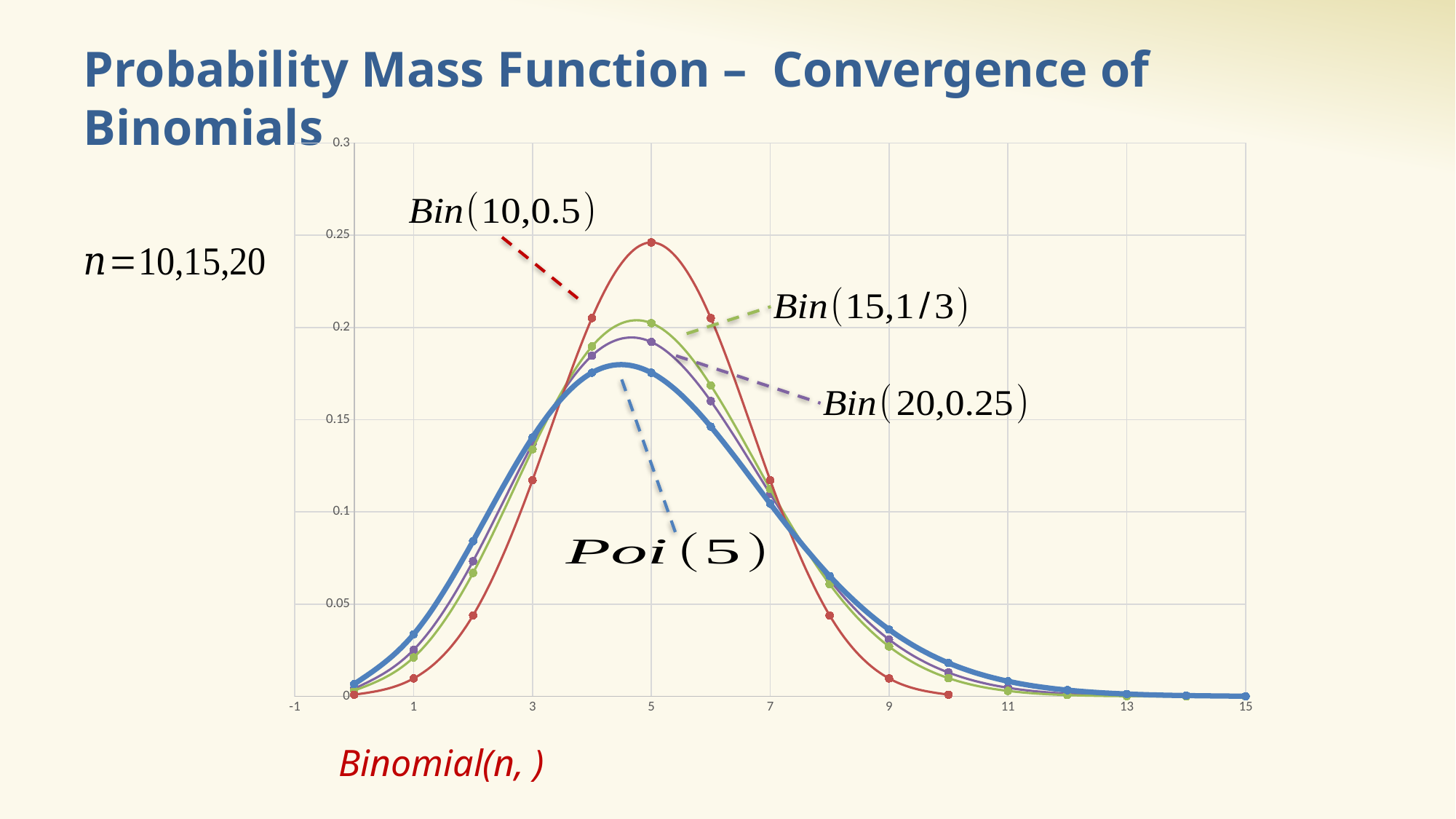
Is the value of the Bin(10,0.5) curve at x = 9 greater or less than 0.05? less Is the peak value of the Poi(5) curve greater or less than 0.2? less Is the value of the Bin(10,0.5) curve at x = 3 greater or less than 0.1? greater Which labelled curve has the lowest peak value? Poi(5) How many distribution curves are labelled on the chart? 4 What kind of chart is shown on the slide? line chart At x = 5, which curve has the larger value: Bin(10,0.5) or Poi(5)? Bin(10,0.5) How do the values of the Poi(5) curve change as x increases from 0 to 15? rise then fall What colour is the Poi(5) curve? blue Which labelled curve reaches the highest peak value? Bin(10,0.5) What is the highest value shown on the y axis? 0.3